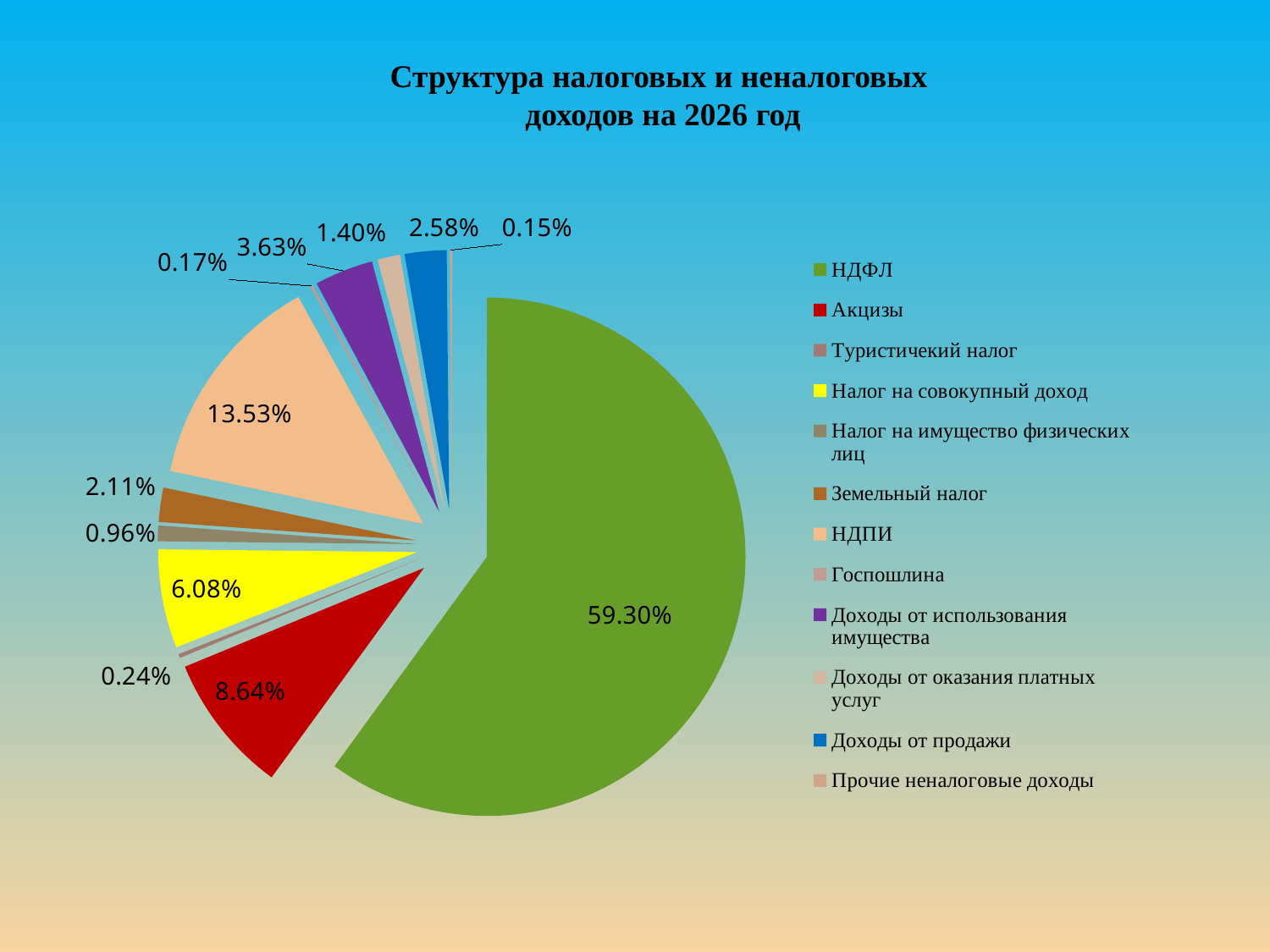
What is the title of the chart? Структура налоговых и неналоговых доходов на 2026 год What is the share of Налог на совокупный доход in the pie chart? 6.08% What type of chart is shown on the slide? pie chart What is the difference between the shares of НДПИ and Акцизы? 4.89% What is the share of НДФЛ in the pie chart? 59.30% What is the share of Доходы от использования имущества in the pie chart? 3.63% Which category has the smallest share of the pie? Прочие неналоговые доходы What is the share of НДПИ in the pie chart? 13.53% How many categories does the legend list? 12 Which is larger: the share of Земельный налог or the share of Доходы от продажи? Доходы от продажи Which category has the largest share of the pie? НДФЛ What is the share of Акцизы in the pie chart? 8.64%